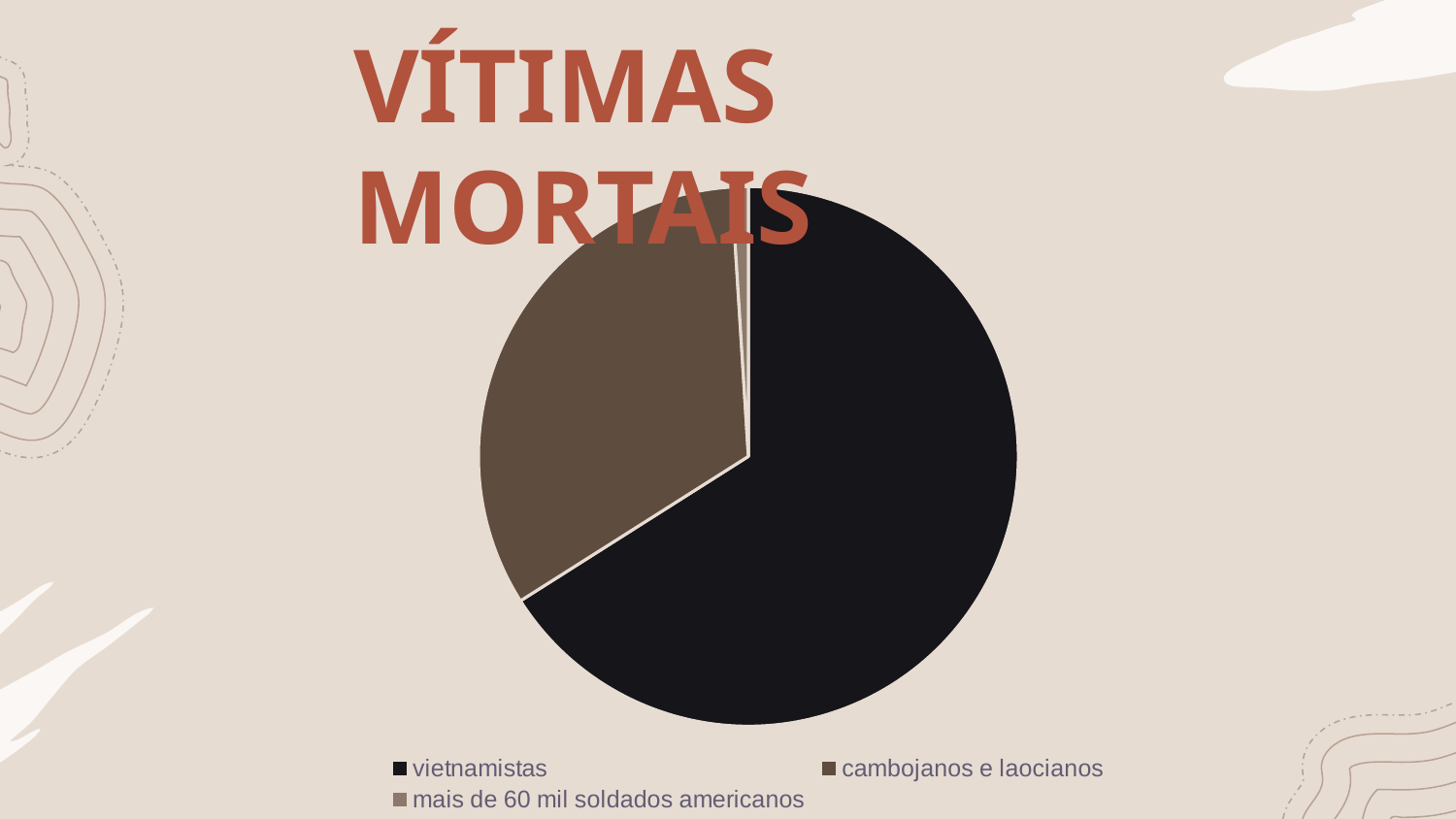
What colour is the slice for vietnamistas in the pie chart? black How many slices does the pie chart have? 3 What is the title shown above the pie chart? VÍTIMAS MORTAIS What kind of chart is shown on the slide? pie chart Which slice is larger: vietnamistas or cambojanos e laocianos? vietnamistas How many entries does the legend of the pie chart list? 3 Which slice is larger: cambojanos e laocianos or mais de 60 mil soldados americanos? cambojanos e laocianos Which category has the largest slice of the pie chart? vietnamistas Which slice is smaller: vietnamistas or mais de 60 mil soldados americanos? mais de 60 mil soldados americanos Which category has the smallest slice of the pie chart? mais de 60 mil soldados americanos